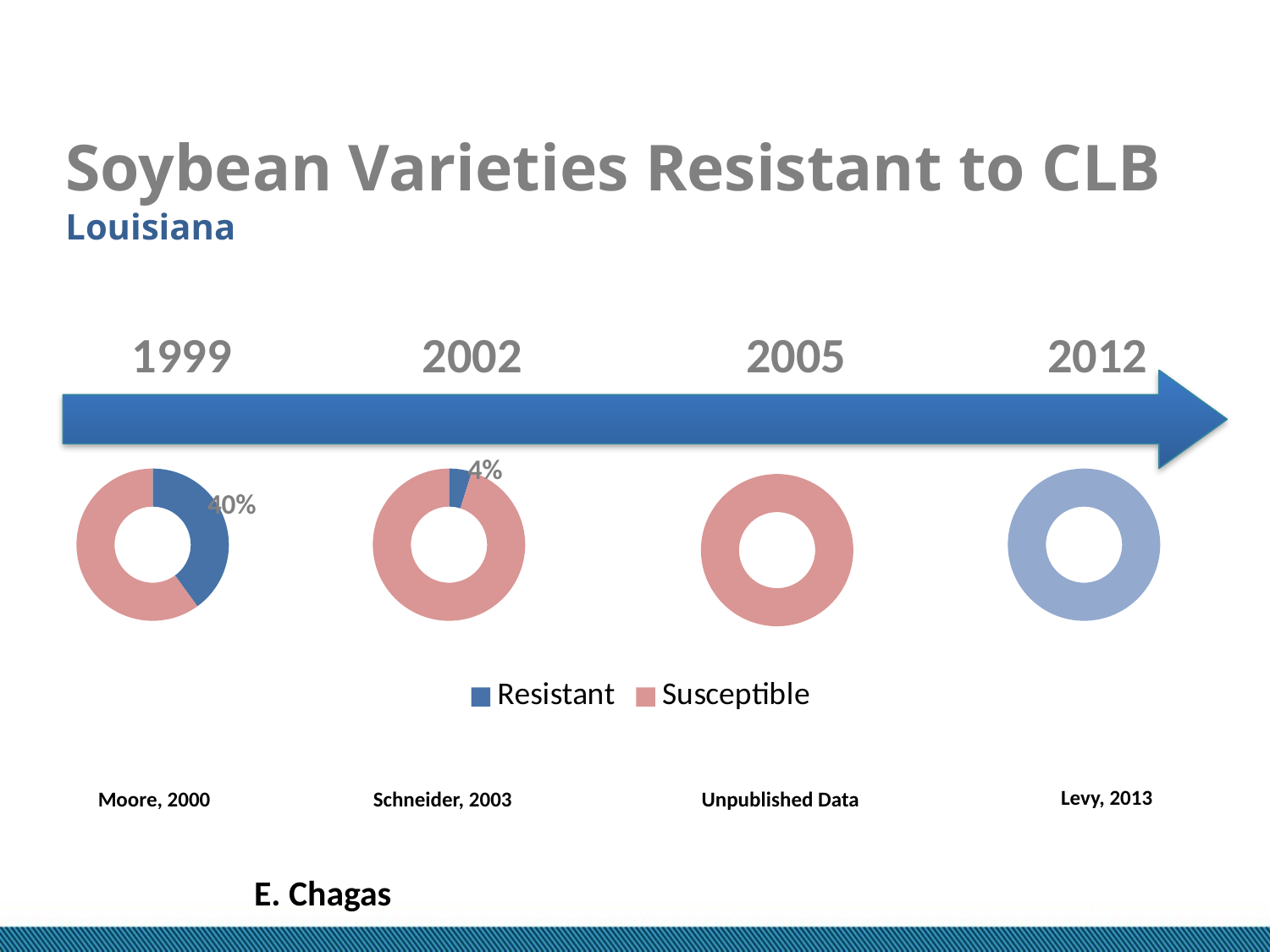
By how many percentage points does the Resistant share in the 1999 chart exceed the Resistant share in the 2002 chart? 36 percentage points What kind of chart is used to show the Resistant and Susceptible shares for each year? Doughnut chart In the 2002 doughnut chart, what percentage of soybean varieties is labelled as Resistant? 4% Which year's chart shows a larger Resistant share, 1999 or 2002? 1999 Does the Resistant share rise or fall from the 1999 chart to the 2002 chart? Fall How many series does the legend list? 2 Which year's doughnut chart has the smallest labelled Resistant share? 2002 Which colour represents Susceptible in the legend? Pink How many doughnut charts are shown on the slide? 4 What are the two entries in the legend? Resistant and Susceptible In the 1999 doughnut chart, what percentage of soybean varieties is labelled as Resistant? 40% In the 1999 doughnut chart, which segment is larger, Resistant or Susceptible? Susceptible